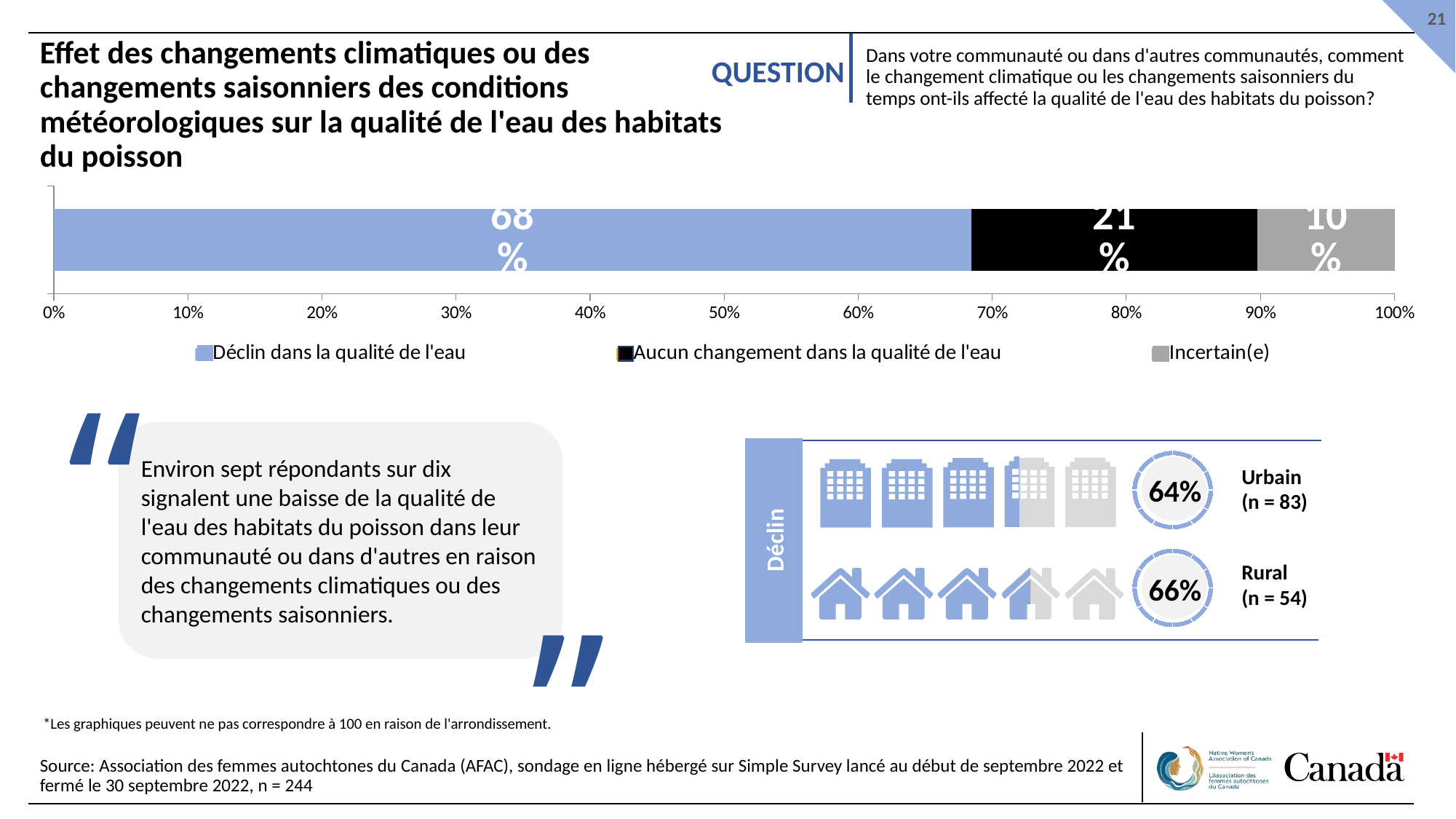
How many series does the legend of the stacked bar chart list? 3 What kind of chart is used to show the survey responses at the top of the slide? Stacked bar chart In the 'Déclin' infographic, what percentage is shown for Urbain respondents? 64% Which response category has the smallest share in the stacked bar? Incertain(e) What percentage of respondents reported a decline in water quality (Déclin dans la qualité de l'eau)? 68% What is the total of the three segments in the stacked bar? 99% What percentage of respondents reported no change in water quality (Aucun changement dans la qualité de l'eau)? 21% Which response category has the largest share in the stacked bar? Déclin dans la qualité de l'eau Which is larger: the share for 'Aucun changement dans la qualité de l'eau' or the share for 'Incertain(e)'? Aucun changement dans la qualité de l'eau What percentage of respondents answered Incertain(e)? 10% What is the difference in percentage points between 'Déclin dans la qualité de l'eau' and 'Aucun changement dans la qualité de l'eau'? 47 In the 'Déclin' infographic, what percentage is shown for Rural respondents? 66%